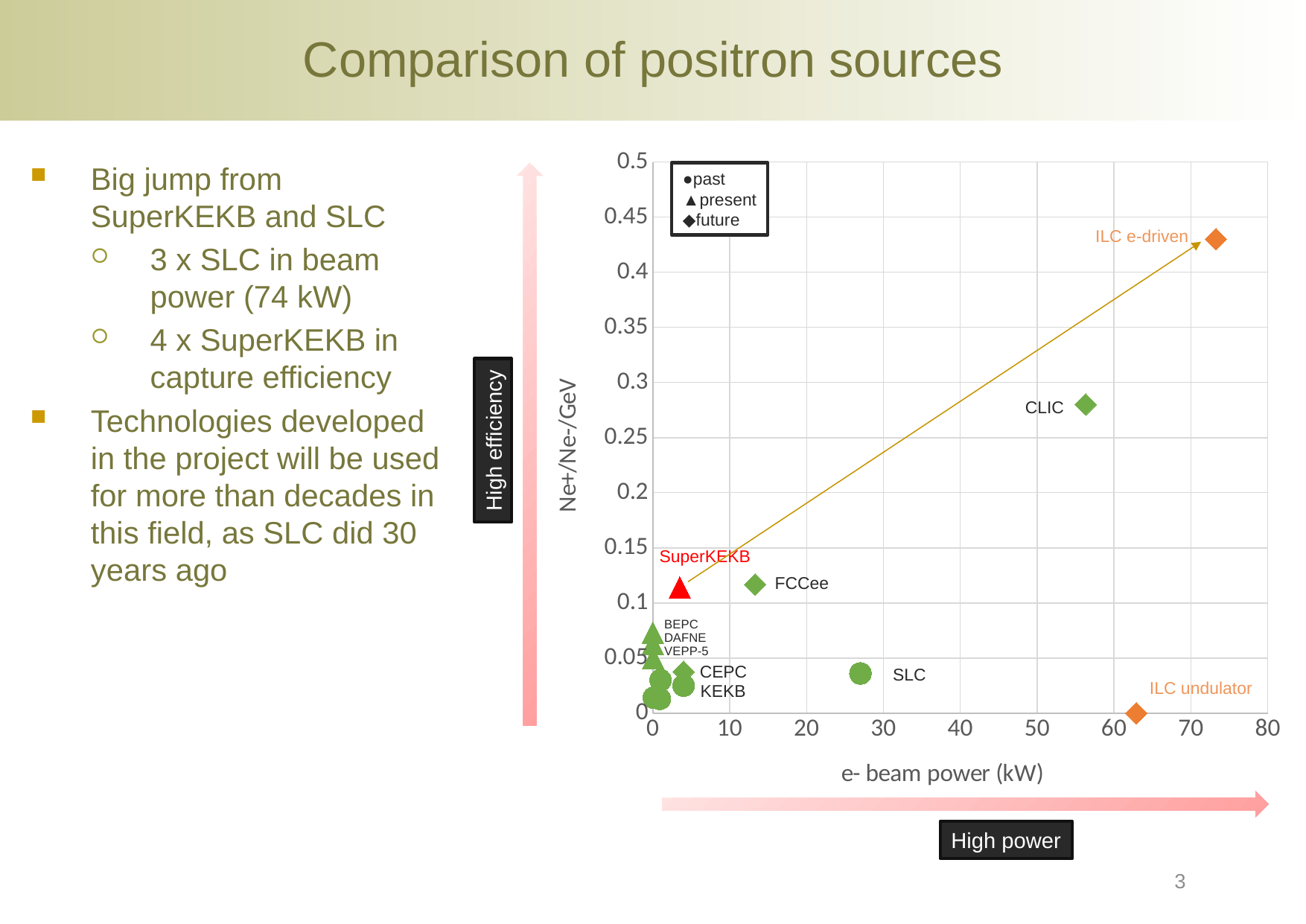
Is the e- beam power for ILC undulator greater or less than 60 kW? greater Which has the higher e- beam power, SLC or SuperKEKB? SLC Which positron source has the highest e- beam power in the chart? ILC e-driven Which has the higher Ne+/Ne-/GeV value, CLIC or FCCee? CLIC Is the Ne+/Ne-/GeV value for ILC e-driven greater or less than 0.4? greater What kind of chart is shown on the slide? scatter chart Is the e- beam power for SLC greater or less than 30 kW? less What is the title of the x axis of the chart? e- beam power (kW) Which positron source has the highest Ne+/Ne-/GeV value in the chart? ILC e-driven Which labelled positron source has the lowest Ne+/Ne-/GeV value in the chart? ILC undulator How many categories does the chart's legend list? 3